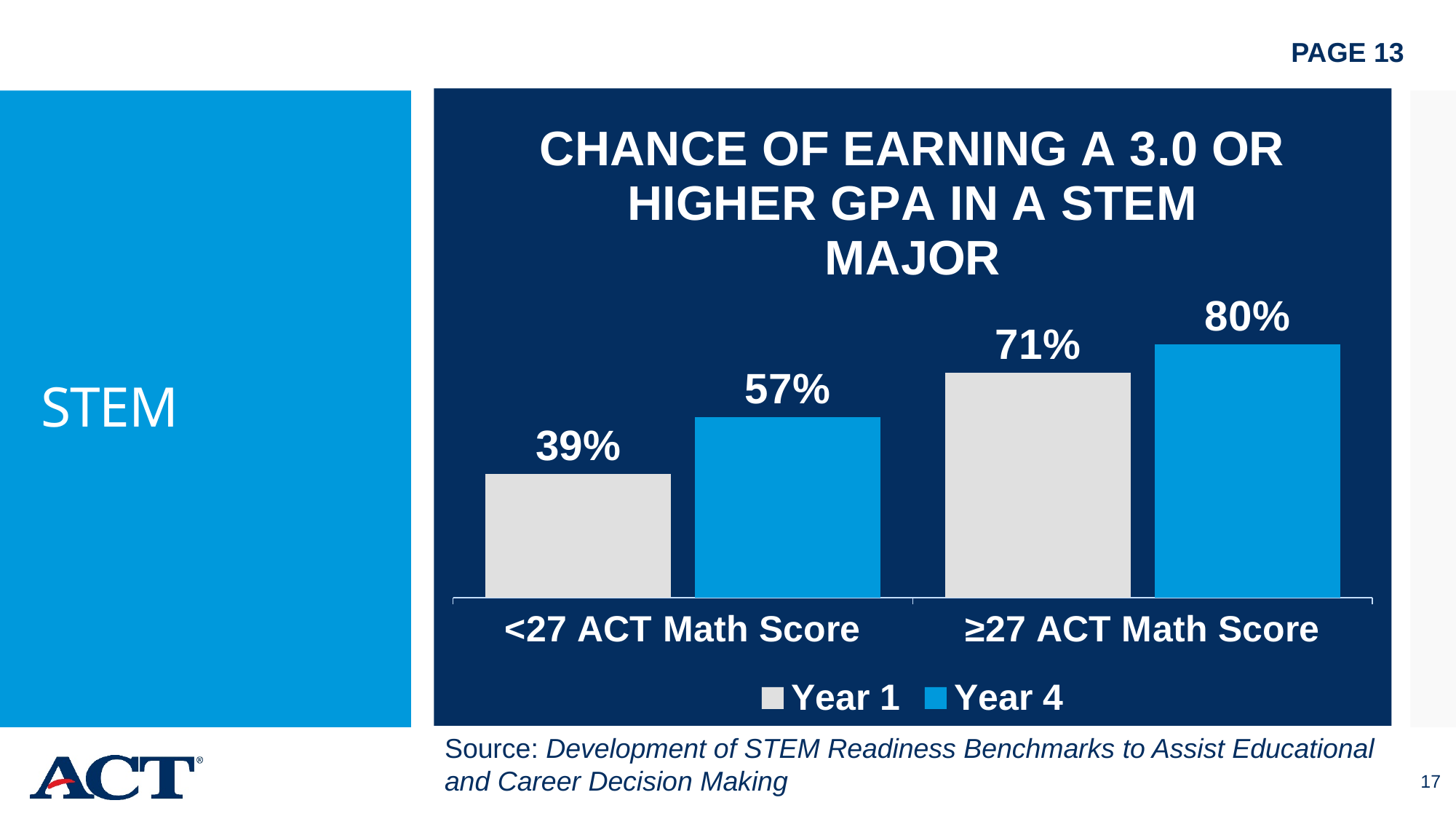
What is the difference between the Year 1 values for ≥27 ACT Math Score and <27 ACT Math Score? 32% What kind of chart is shown on the slide? Bar chart Which bar has the highest value on the chart? Year 4, ≥27 ACT Math Score Which bar has the lowest value on the chart? Year 1, <27 ACT Math Score What is the difference between the Year 4 and Year 1 values for <27 ACT Math Score? 18% How many categories are shown on the x axis? 2 How many series does the legend list? 2 What is the Year 4 value for <27 ACT Math Score? 57% What is the Year 1 value for ≥27 ACT Math Score? 71% Which is larger: the Year 4 value for <27 ACT Math Score or the Year 1 value for ≥27 ACT Math Score? Year 1 value for ≥27 ACT Math Score What is the Year 4 value for ≥27 ACT Math Score? 80% What is the Year 1 value for <27 ACT Math Score? 39%